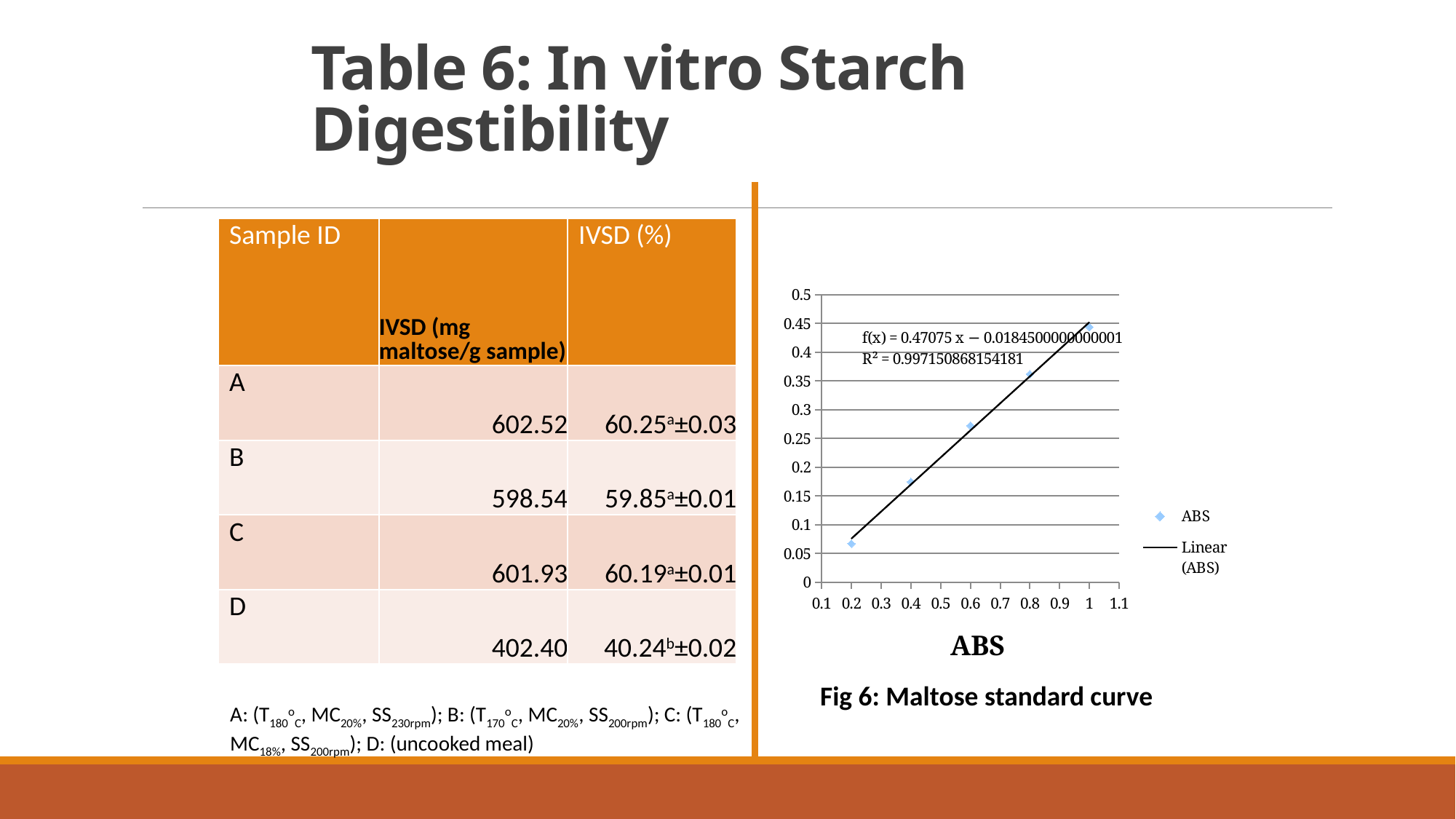
In Fig 6: Maltose standard curve, is the plotted value at x = 1 greater or less than 0.4? greater In Fig 6: Maltose standard curve, at which x value is the lowest plotted point? 0.2 In Fig 6: Maltose standard curve, do the plotted values rise or fall as ABS increases along the x axis? rise In Fig 6: Maltose standard curve, is the plotted value at x = 0.2 greater or less than 0.1? less What R² value is printed on the chart in Fig 6: Maltose standard curve? 0.997150868154181 In Fig 6: Maltose standard curve, is the plotted value at x = 0.8 greater or less than 0.3? greater In Fig 6: Maltose standard curve, which plotted point is larger, the one at x = 0.8 or the one at x = 0.4? x = 0.8 In Fig 6: Maltose standard curve, how many data points are plotted? 5 In Fig 6: Maltose standard curve, at which x value is the highest plotted point? 1 In Fig 6: Maltose standard curve, how many entries does the legend list? 2 What kind of chart is shown in Fig 6: Maltose standard curve? scatter chart with a linear trendline What is the x-axis title of the chart in Fig 6: Maltose standard curve? ABS